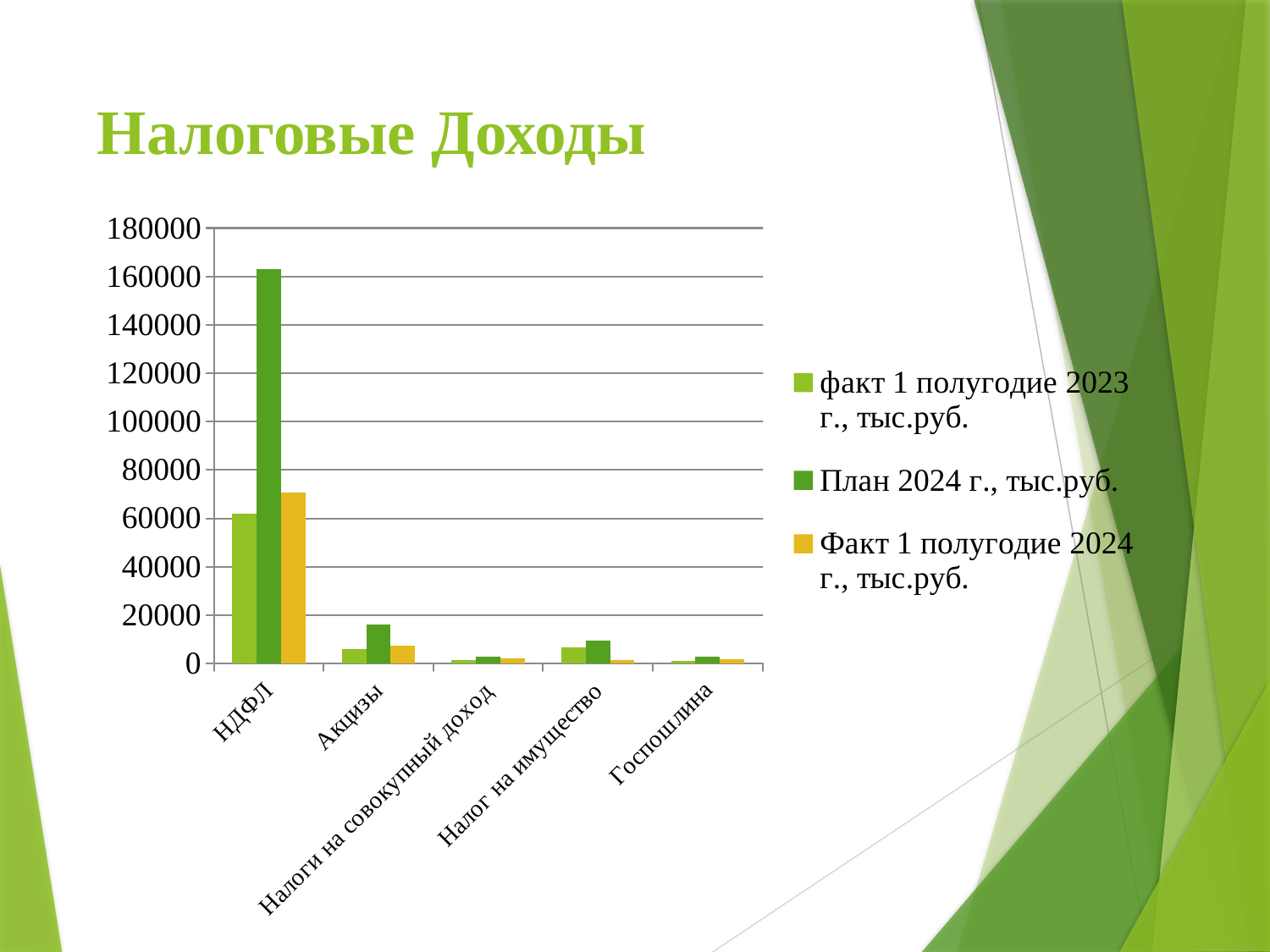
How many categories are shown on the x axis of the chart? 5 For Акцизы, which series has the larger value: "План 2024 г., тыс.руб." or "Факт 1 полугодие 2024 г., тыс.руб."? План 2024 г., тыс.руб. Is the value for НДФЛ in the series "Факт 1 полугодие 2024 г., тыс.руб." greater or less than 60000? greater Is the value for НДФЛ in the series "факт 1 полугодие 2023 г., тыс.руб." greater or less than 80000? less How many series does the legend list? 3 What kind of chart is shown on the slide? bar chart What is the title of the slide containing the chart? Налоговые Доходы For НДФЛ, which series has the larger value: "План 2024 г., тыс.руб." or "факт 1 полугодие 2023 г., тыс.руб."? План 2024 г., тыс.руб. Which category has the highest value for the series "факт 1 полугодие 2023 г., тыс.руб."? НДФЛ Is the value for НДФЛ in the series "План 2024 г., тыс.руб." greater or less than 140000? greater Which category has the highest value for the series "План 2024 г., тыс.руб."? НДФЛ